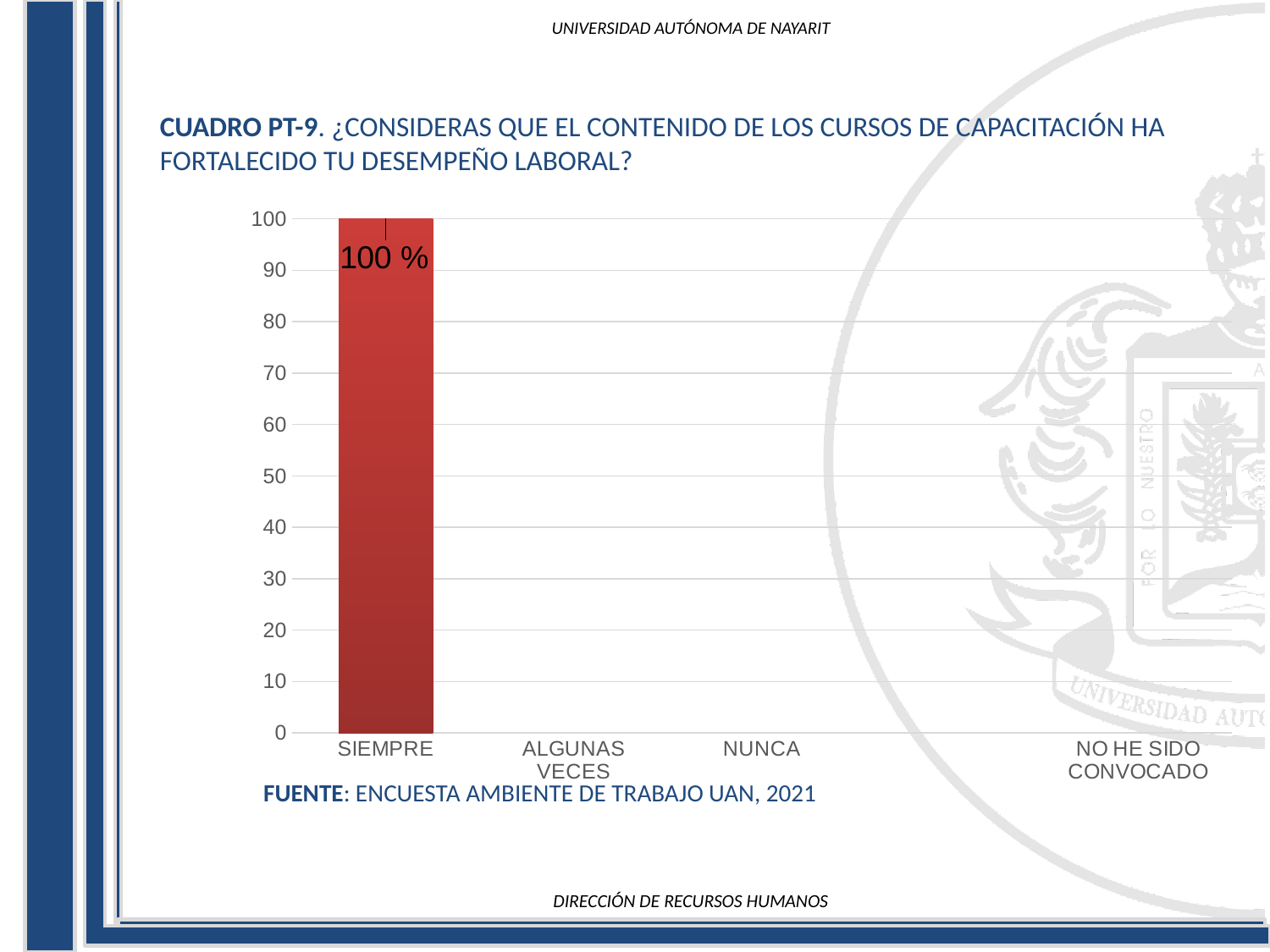
What colour is the bar for SIEMPRE? Red What value is shown for SIEMPRE? 100 % How many categories are shown on the x axis? 4 Which category is listed first on the x axis? SIEMPRE Which category is listed last on the x axis? NO HE SIDO CONVOCADO Which category has the highest value? SIEMPRE Is the value for SIEMPRE greater or less than 90? greater What is the highest value shown on the y axis? 100 What kind of chart is shown on the slide? Bar chart